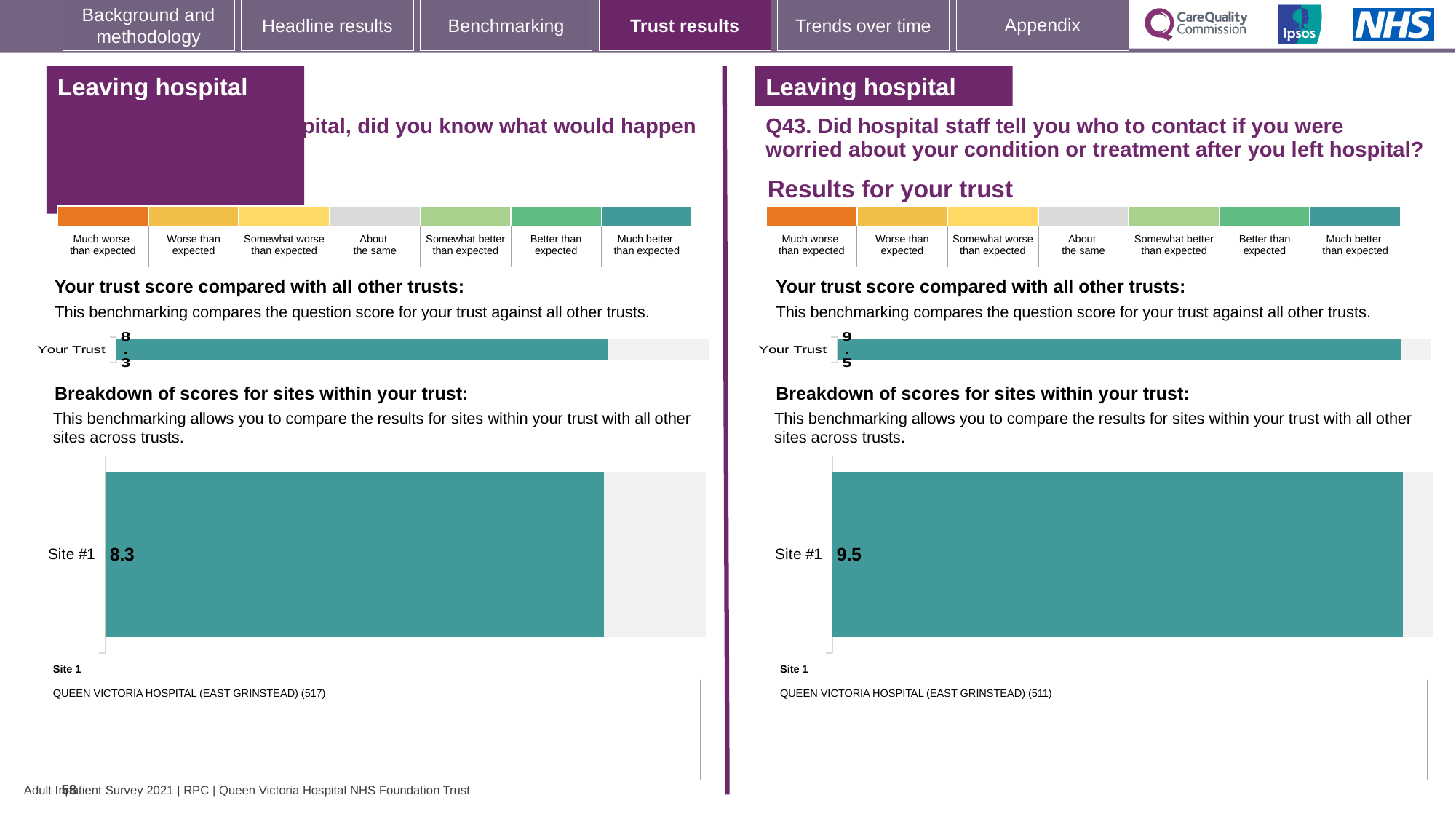
Which of the two 'Your Trust' bars on the slide is longer, the left-hand one or the right-hand one? The right-hand one On the right-hand 'Your trust score compared with all other trusts' chart for Q43, what is the value for Your Trust? 9.5 How many sites are shown in the right-hand Q43 'Breakdown of scores for sites within your trust' chart? 1 On the left-hand chart (breakdown of scores for sites within your trust), what is the score for Site #1? 8.3 What kind of chart is used to show the Site #1 score on the right-hand side of the slide? Bar chart How many sites are shown in the left-hand 'Breakdown of scores for sites within your trust' chart? 1 On the right-hand chart for Q43 (breakdown of scores for sites within your trust), what is the score for Site #1? 9.5 On the left-hand 'Your trust score compared with all other trusts' chart, what is the value for Your Trust? 8.3 What is the title of the section heading above the right-hand Q43 benchmarking charts? Results for your trust According to the site key below the right-hand Q43 chart, which hospital is Site 1? QUEEN VICTORIA HOSPITAL (EAST GRINSTEAD) Comparing the Site #1 scores on the left-hand and right-hand site breakdown charts, which chart shows the larger value? The right-hand chart (Q43) What is the difference between the Site #1 score on the right-hand Q43 chart and the Site #1 score on the left-hand chart? 1.2